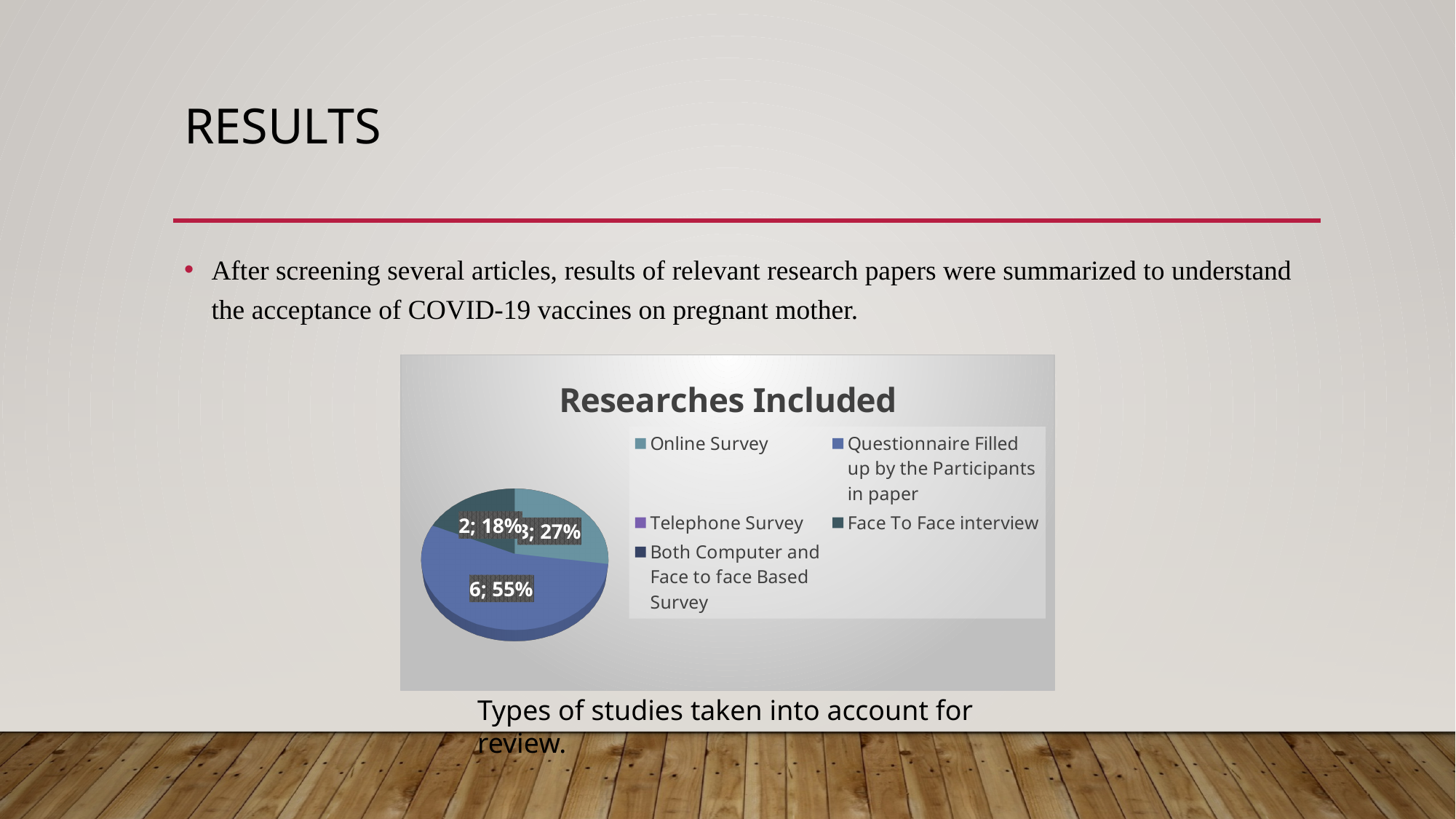
What kind of chart is shown on the slide? Pie chart What is the difference in the number of researches between 'Questionnaire Filled up by the Participants in paper' and 'Face To Face interview'? 4 Which category has the largest slice of the pie? Questionnaire Filled up by the Participants in paper How many researches are counted for 'Face To Face interview'? 2 What share of the pie does the 'Face To Face interview' slice represent? 18% How many researches are counted for 'Questionnaire Filled up by the Participants in paper'? 6 What colour is the 'Questionnaire Filled up by the Participants in paper' slice? Blue What is the title of the chart? Researches Included How many entries does the chart's legend list? 5 What share of the pie does the 'Questionnaire Filled up by the Participants in paper' slice represent? 55% Is the share for 'Questionnaire Filled up by the Participants in paper' greater or less than 50%? greater Which is larger: the 'Questionnaire Filled up by the Participants in paper' slice or the 'Face To Face interview' slice? Questionnaire Filled up by the Participants in paper